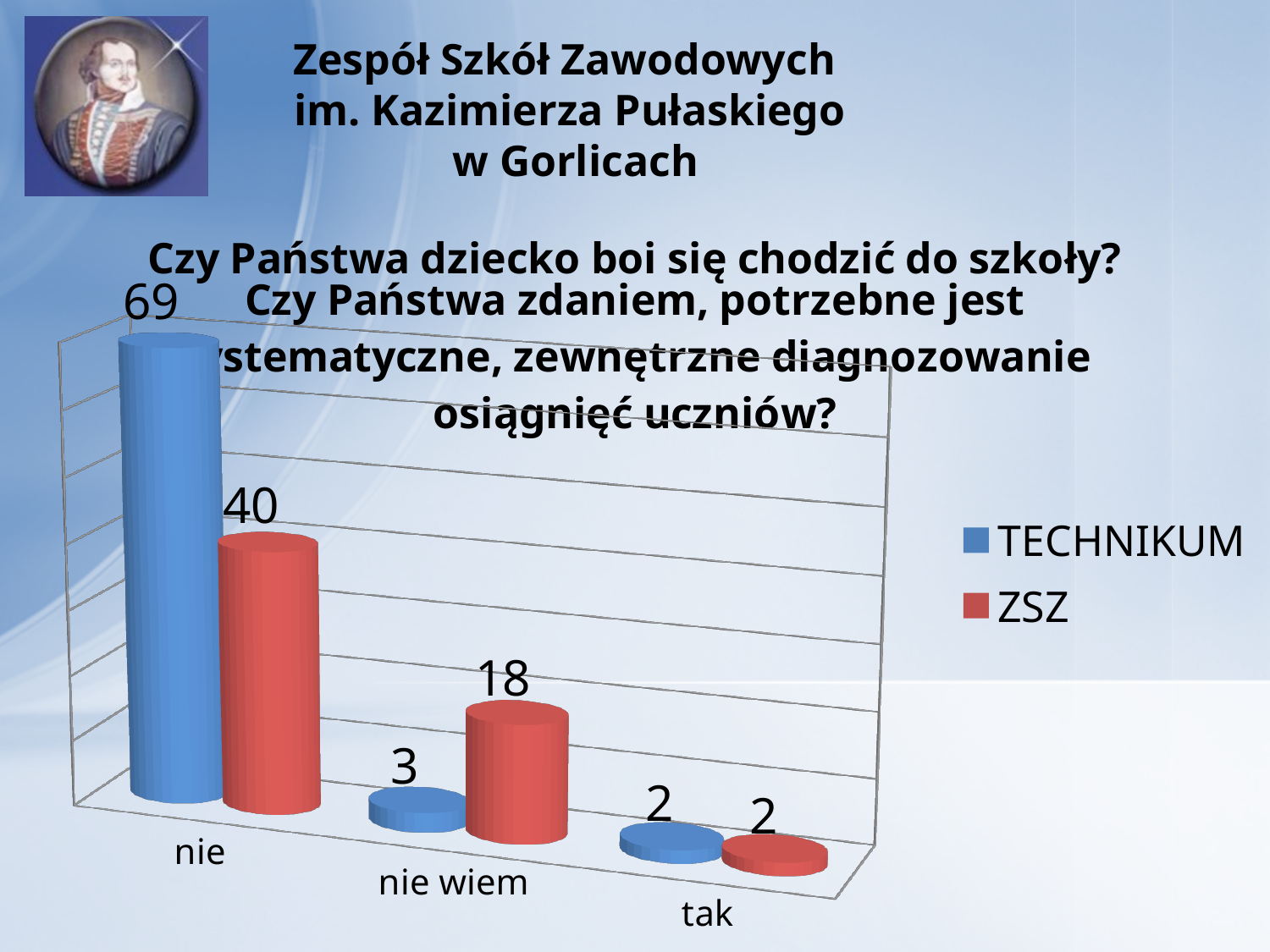
How many series does the legend list? 2 Which category has the lowest value for ZSZ? tak What is the value for ZSZ in the "nie" category? 40 What is the value for TECHNIKUM in the "nie wiem" category? 3 Which category has the highest value for TECHNIKUM? nie What is the difference between the TECHNIKUM and ZSZ values in the "nie" category? 29 What is the value for TECHNIKUM in the "nie" category? 69 What is the value for TECHNIKUM in the "tak" category? 2 How many categories are shown on the x axis? 3 What kind of chart is shown on the slide? bar chart What is the value for ZSZ in the "nie wiem" category? 18 In the "nie wiem" category, which series has the larger value, TECHNIKUM or ZSZ? ZSZ